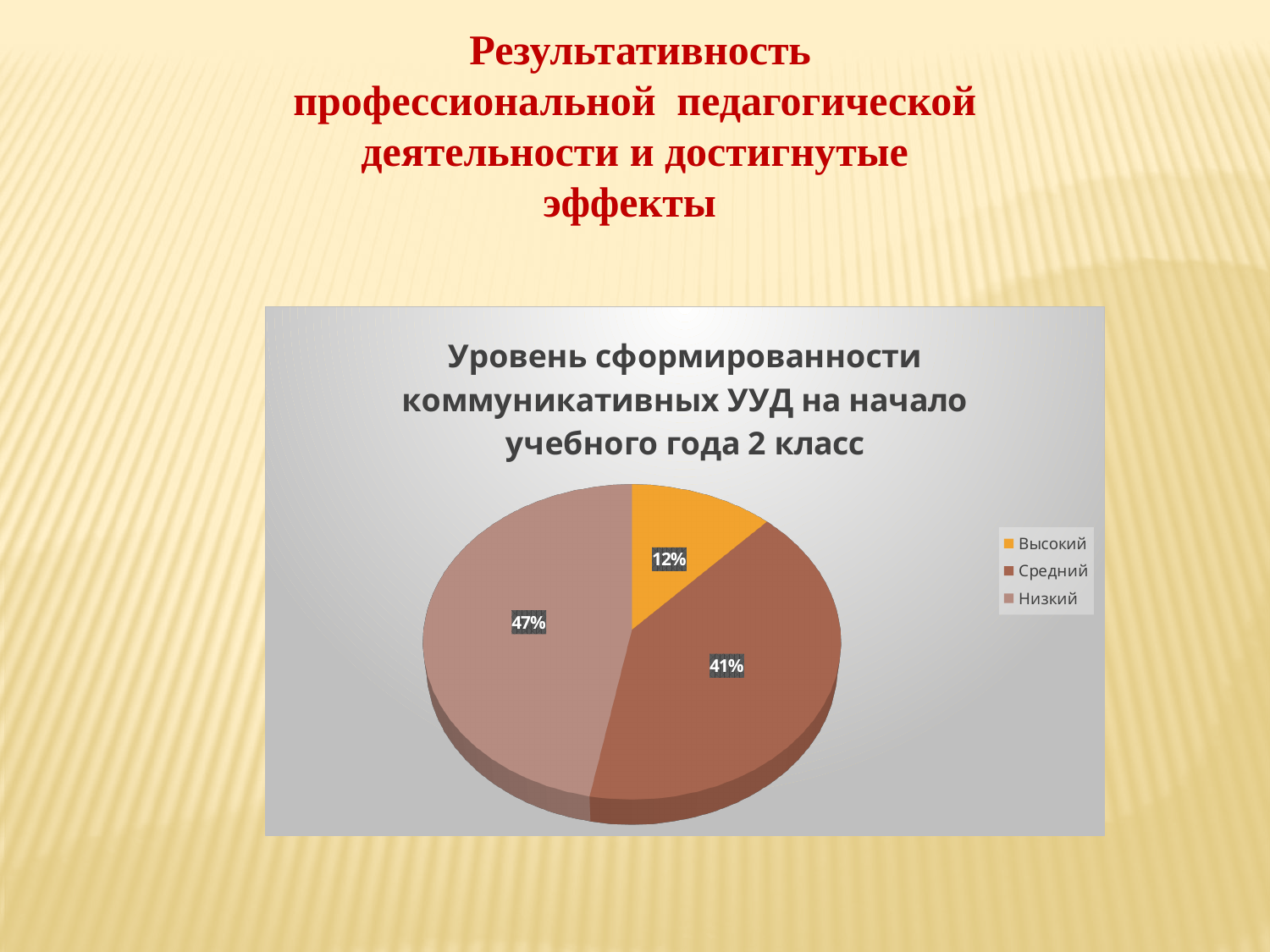
What is the difference between the values for Средний and Высокий? 29% Which is larger, the value for Средний or the value for Высокий? Средний What is the difference between the values for Низкий and Средний? 6% What is the value for Средний? 41% How many categories does the pie chart show? 3 Which category has the largest share of the pie? Низкий What colour is the slice for Высокий? orange Which category has the smallest share of the pie? Высокий What is the value for Высокий? 12% What is the value for Низкий? 47% What type of chart is shown on the slide? pie chart What is the title of the chart? Уровень сформированности коммуникативных УУД на начало учебного года 2 класс